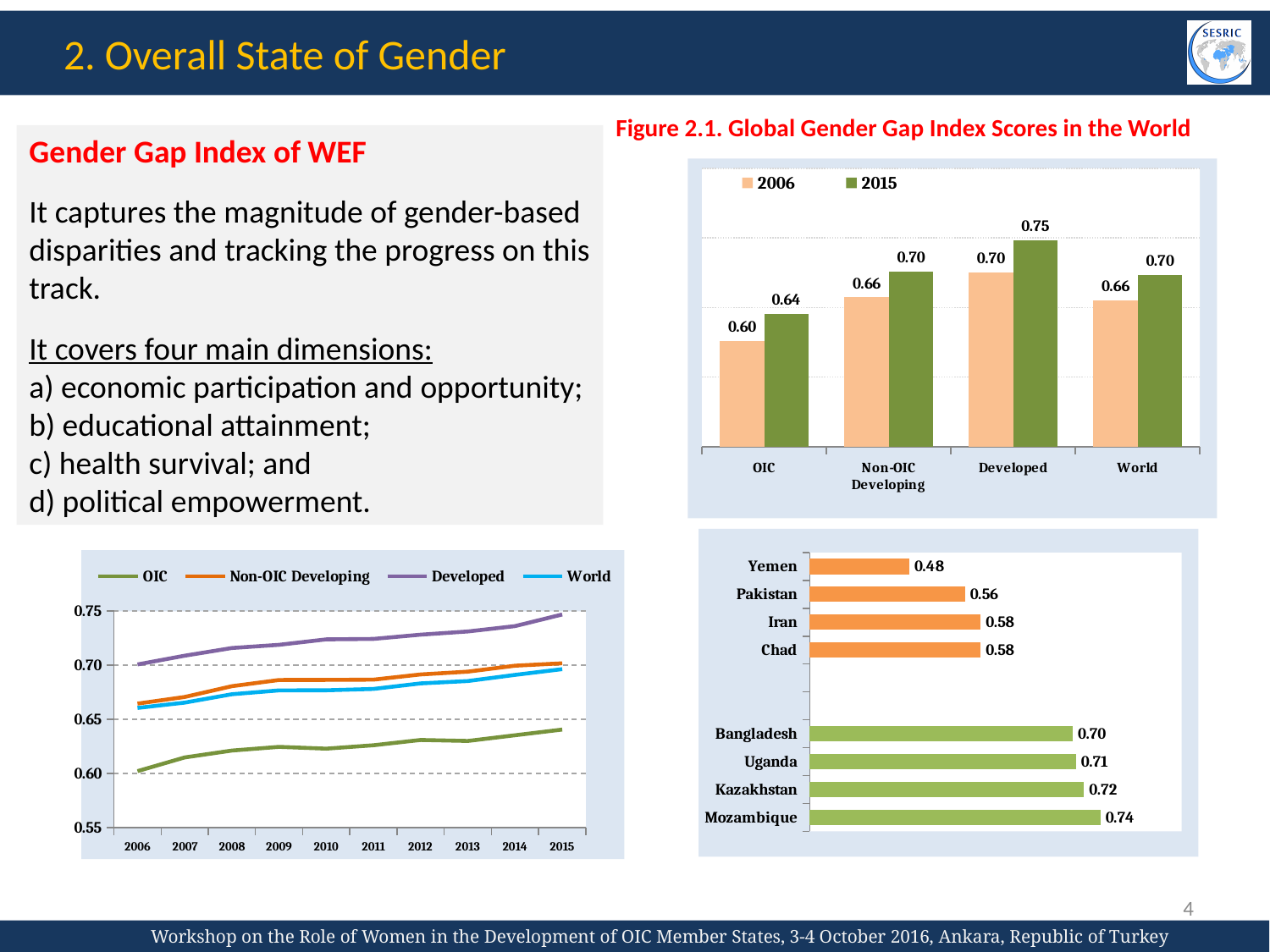
In the chart titled 'Figure 2.1. Global Gender Gap Index Scores in the World', what is the 2015 value for Developed? 0.75 In the chart titled 'Figure 2.1. Global Gender Gap Index Scores in the World', which category has the lowest 2015 value? OIC In the chart titled 'Figure 2.1. Global Gender Gap Index Scores in the World', how many series does the legend list? 2 In the line chart at the bottom left of the slide, does the OIC line rise or fall from 2006 to 2015? rise In the line chart at the bottom left of the slide, is the value for OIC in 2010 greater or less than 0.65? less In the line chart at the bottom left of the slide, how many series does the legend list? 4 In the chart titled 'Figure 2.1. Global Gender Gap Index Scores in the World', what is the difference between the 2015 and 2006 values for OIC? 0.04 In the horizontal bar chart at the bottom right of the slide, which country has the highest value? Mozambique In the horizontal bar chart at the bottom right of the slide, how many countries are shown? 8 In the horizontal bar chart at the bottom right of the slide, what is the value for Yemen? 0.48 In the chart titled 'Figure 2.1. Global Gender Gap Index Scores in the World', what is the 2006 value for OIC? 0.60 In the chart titled 'Figure 2.1. Global Gender Gap Index Scores in the World', which is larger: the 2015 value for Developed or the 2015 value for World? Developed